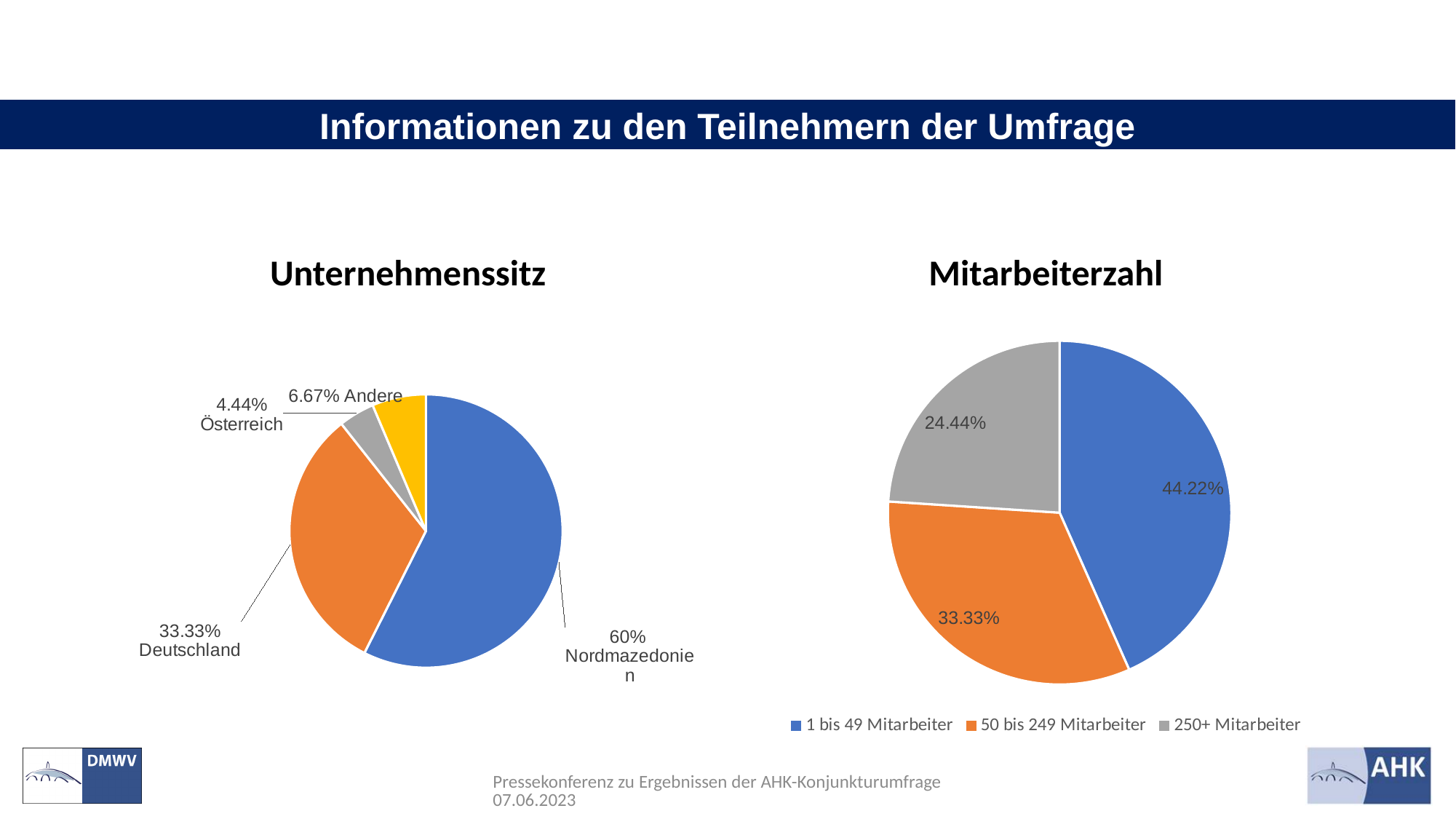
In the Mitarbeiterzahl chart, what share of participants have 1 bis 49 Mitarbeiter? 44.22% In the Mitarbeiterzahl chart, which category has the largest share? 1 bis 49 Mitarbeiter In the Unternehmenssitz chart, which category has the smallest share? Österreich In the Unternehmenssitz chart, what is the difference between the Nordmazedonien and Deutschland shares? 26.67% In the Unternehmenssitz chart, what share is labelled Österreich? 4.44% What type of chart is the Mitarbeiterzahl chart? Pie chart In the Unternehmenssitz chart, what share of participants are based in Deutschland? 33.33% In the Unternehmenssitz chart, what share of participants are based in Nordmazedonien? 60% In the Mitarbeiterzahl chart, what share of participants have 250+ Mitarbeiter? 24.44% In the Unternehmenssitz chart, how many slices does the pie have? 4 In the Mitarbeiterzahl chart, which is larger: the share for 50 bis 249 Mitarbeiter or for 250+ Mitarbeiter? 50 bis 249 Mitarbeiter In the Mitarbeiterzahl chart, how many entries does the legend list? 3